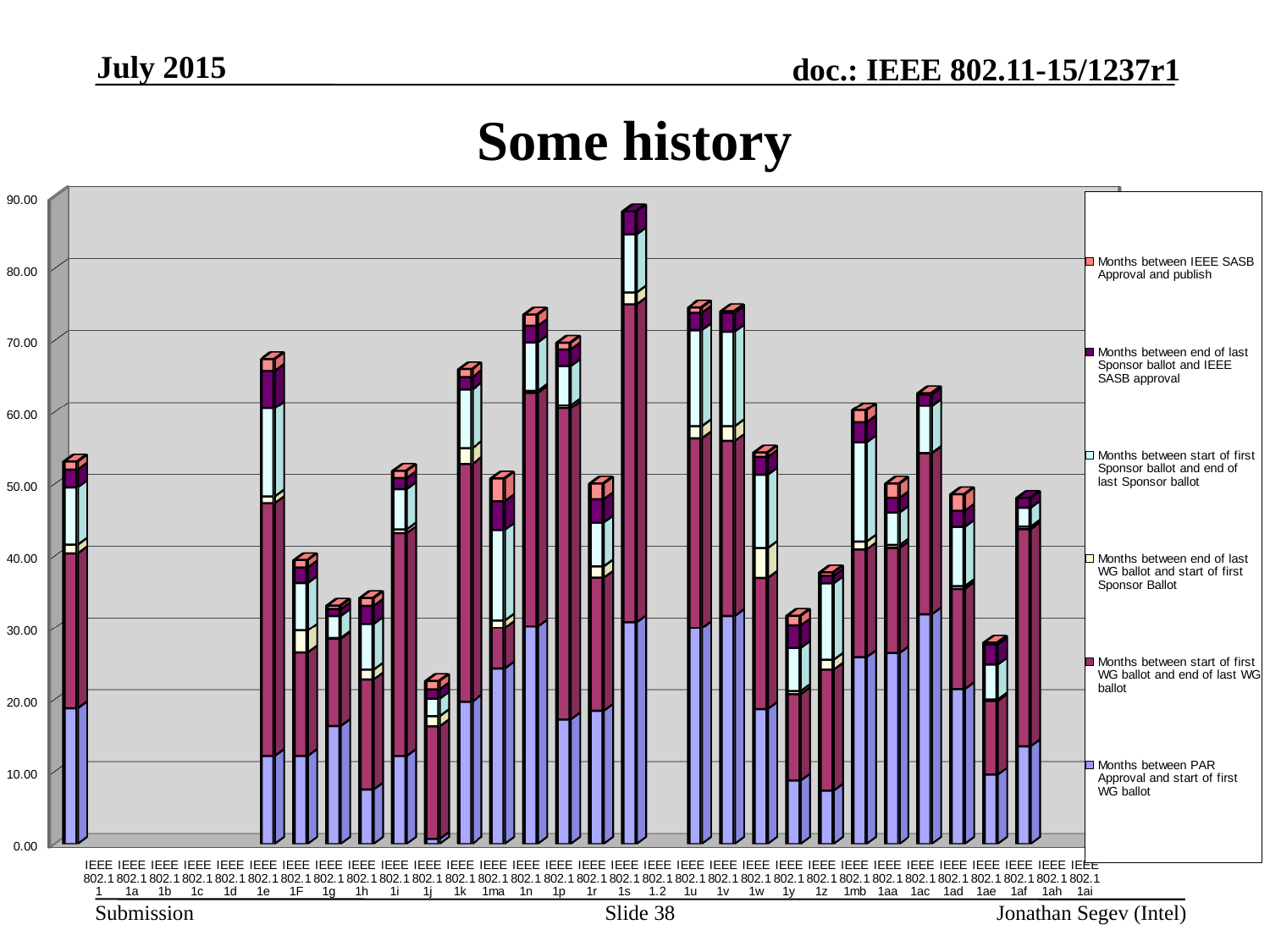
Is the total for IEEE 802.11j greater or less than 30? less Which category has the tallest stacked bar? IEEE 802.11s Is the total for IEEE 802.11u greater or less than 70? greater Is the total for IEEE 802.11e greater or less than 60? greater Which has the taller stacked bar, IEEE 802.11n or IEEE 802.11g? IEEE 802.11n What kind of chart is shown on the slide? stacked bar chart Which series is listed last (at the bottom) in the legend? Months between PAR Approval and start of first WG ballot How many series does the legend list? 6 Which has the taller stacked bar, IEEE 802.11k or IEEE 802.11ma? IEEE 802.11k What is the title of the chart? Some history